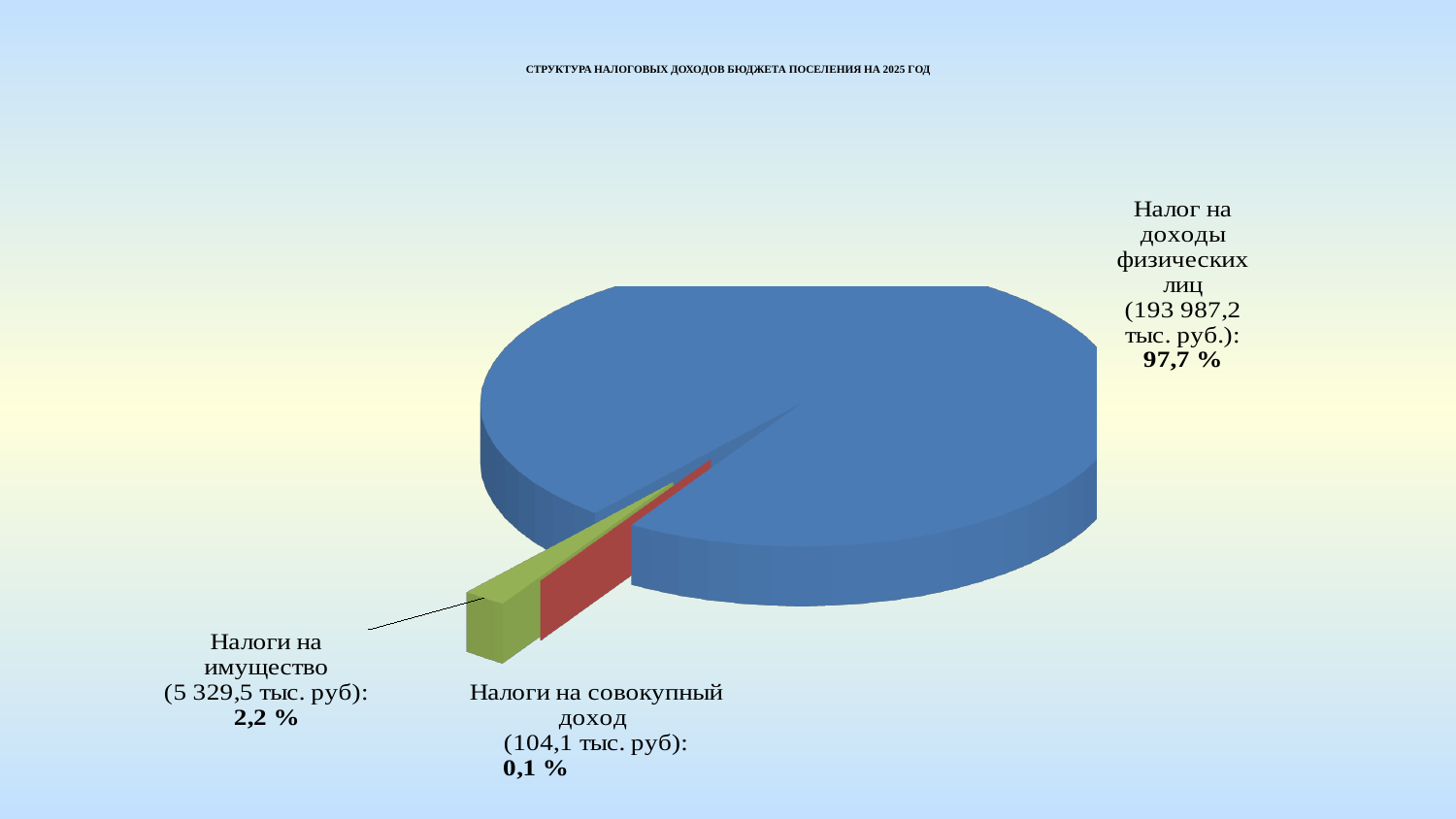
Which category has the smallest slice of the pie? Налоги на совокупный доход How many slices does the pie chart have? 3 What type of chart is shown on the slide? Pie chart What share of the pie does Налог на доходы физических лиц represent? 97,7 % Which category has the largest slice of the pie? Налог на доходы физических лиц What share of the pie does Налоги на имущество represent? 2,2 % What is the value shown for Налоги на совокупный доход? 104,1 тыс. руб. What is the value shown for Налог на доходы физических лиц? 193 987,2 тыс. руб. What share of the pie does Налоги на совокупный доход represent? 0,1 % What is the title of the chart? СТРУКТУРА НАЛОГОВЫХ ДОХОДОВ БЮДЖЕТА ПОСЕЛЕНИЯ НА 2025 ГОД Which is larger: Налоги на имущество or Налоги на совокупный доход? Налоги на имущество What is the value shown for Налоги на имущество? 5 329,5 тыс. руб